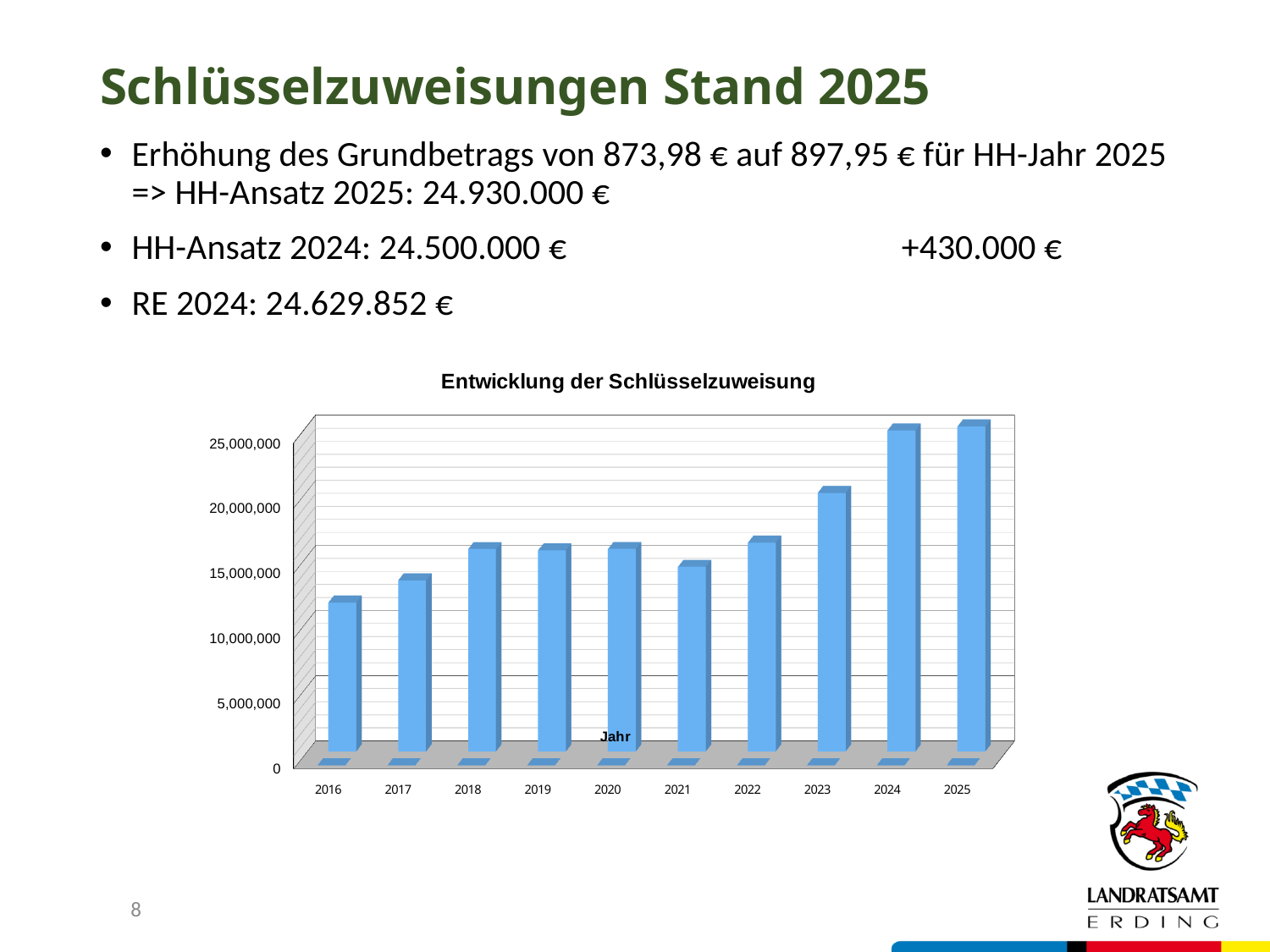
How many years are plotted on the x axis of the chart? 10 What kind of chart is shown on the slide? bar chart Which year has the lowest value in the chart? 2016 Which year has the larger value, 2020 or 2021? 2020 Which year has the larger value, 2022 or 2023? 2023 Overall, do the values rise or fall from 2016 to 2025? rise Is the value for 2016 greater or less than 15,000,000? less What is the title of the chart? Entwicklung der Schlüsselzuweisung Is the value for 2022 greater or less than 20,000,000? less Is the value for 2016 greater or less than 10,000,000? greater